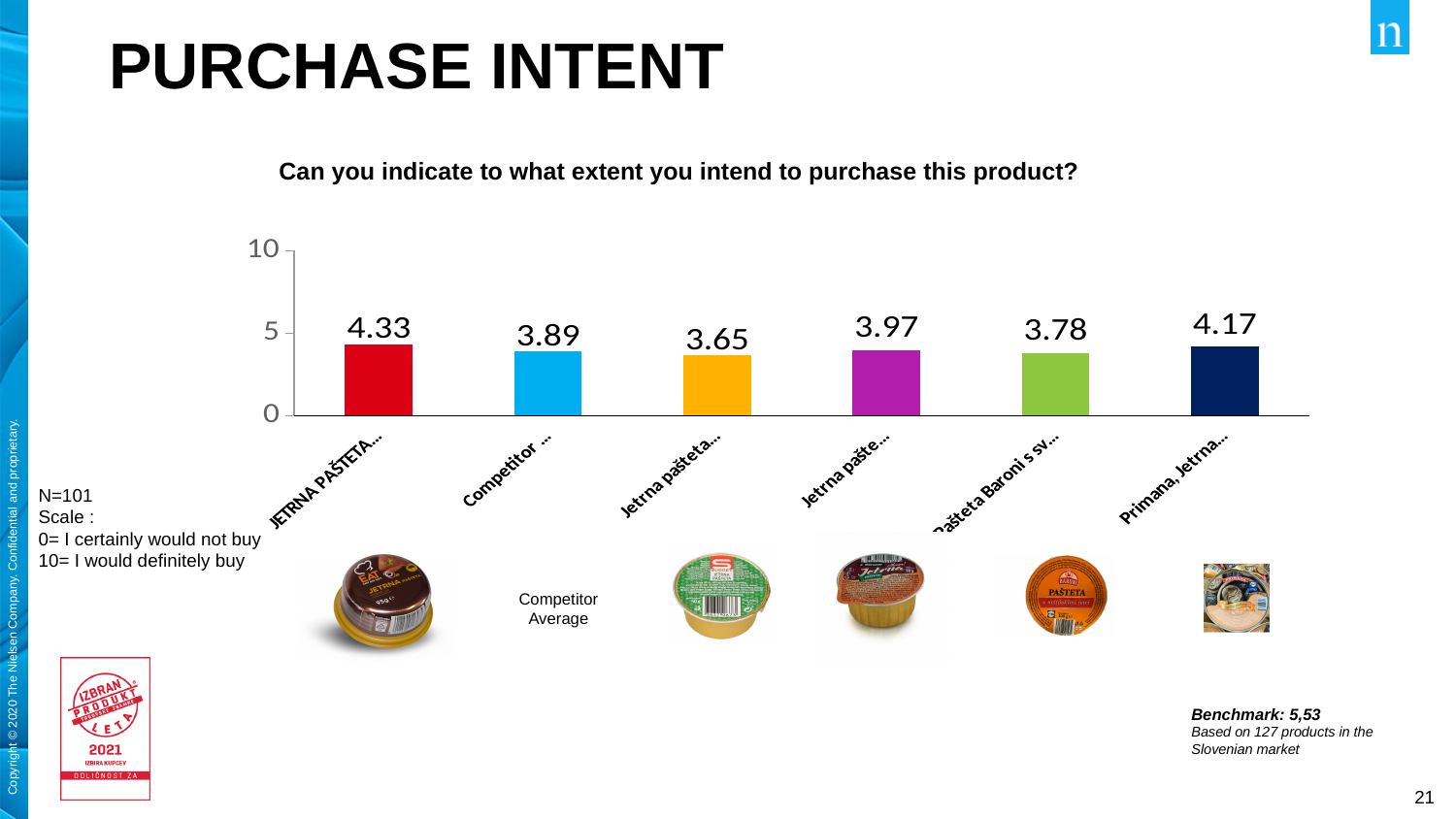
What is the lowest value shown on the chart? 3.65 What is the value of the first (red) bar, labelled JETRNA PAŠTETA…? 4.33 Is the value of the fourth (purple) bar greater or less than 5? less What type of chart is used on this slide? bar chart How many bars are shown on the chart? 6 What is the value of the bar labelled Pašteta Baroni s sv…? 3.78 Which bar has the highest purchase intent value? JETRNA PAŠTETA… (4.33) What is the purchase intent value for the Competitor Average bar? 3.89 What is the value of the last bar, labelled Primana, Jetrna…? 4.17 What is the maximum value shown on the y-axis of the chart? 10 Which is larger: the value for Primana, Jetrna… or the value for Pašteta Baroni s sv…? Primana, Jetrna… What is the difference between the first bar (4.33) and the Competitor Average bar (3.89)? 0.44